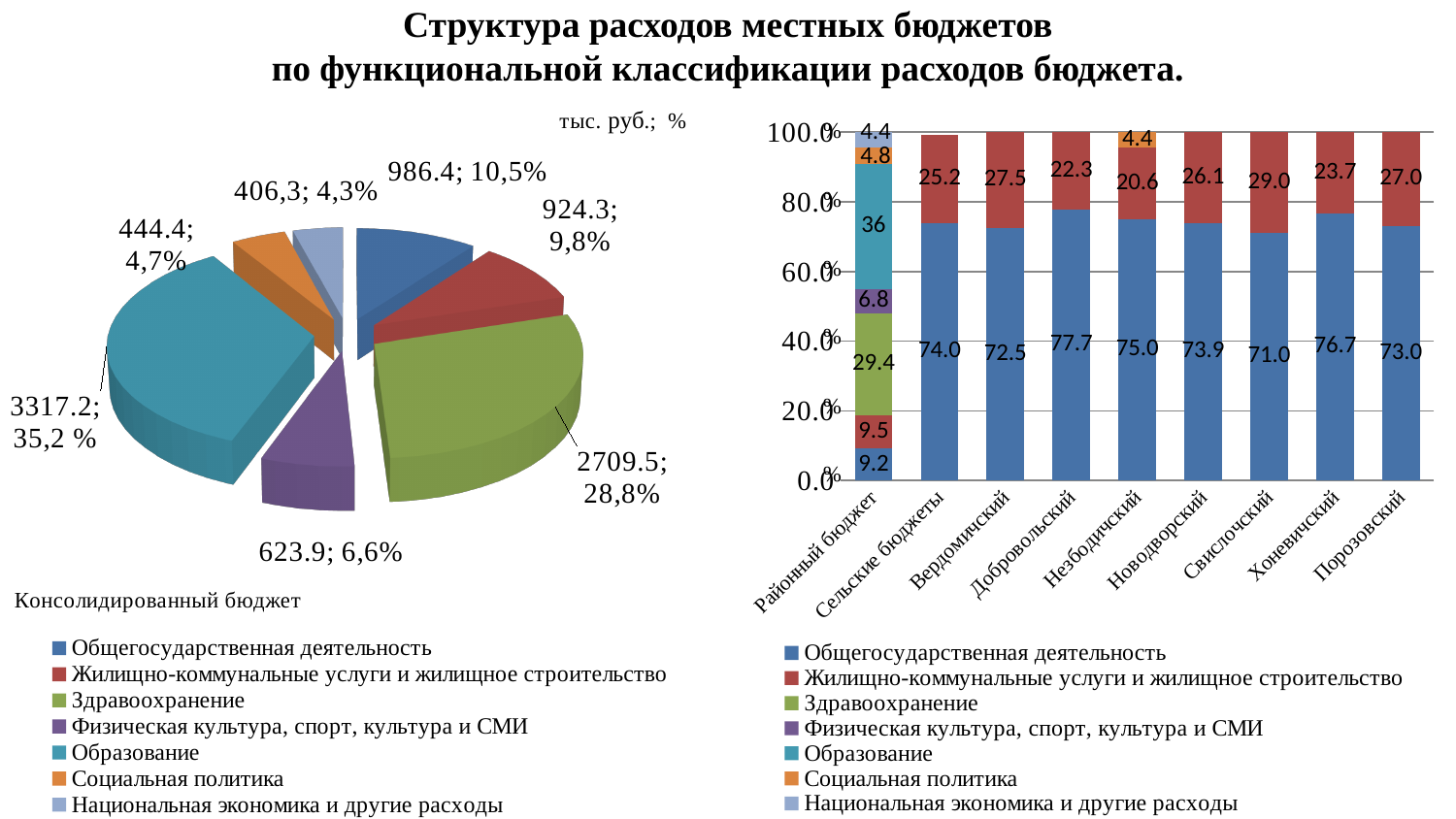
In the stacked bar chart on the right, what is the difference between the Общегосударственная деятельность values for Хоневичский and Свислочский? 5.7 In the pie chart on the left, which category has the smallest share? Национальная экономика и другие расходы In the stacked bar chart on the right, which category has the highest value for Общегосударственная деятельность? Добровольский In the pie chart on the left, how many slices are there? 7 In the stacked bar chart on the right, what is the value of Общегосударственная деятельность for Добровольский? 77.7 In the stacked bar chart on the right, how many categories are shown on the x axis? 9 In the pie chart on the left, which category has the largest share? Образование In the stacked bar chart on the right, what is the value of Образование for Районный бюджет? 36 In the pie chart on the left, what value in thousand rubles is shown for Здравоохранение? 2709.5 In the stacked bar chart on the right, which category has the lowest value for Жилищно-коммунальные услуги и жилищное строительство among the rural budgets (excluding Районный бюджет)? Незбодичский How many series does the legend of the stacked bar chart on the right list? 7 In the pie chart on the left, what is the share of Образование? 35,2 %